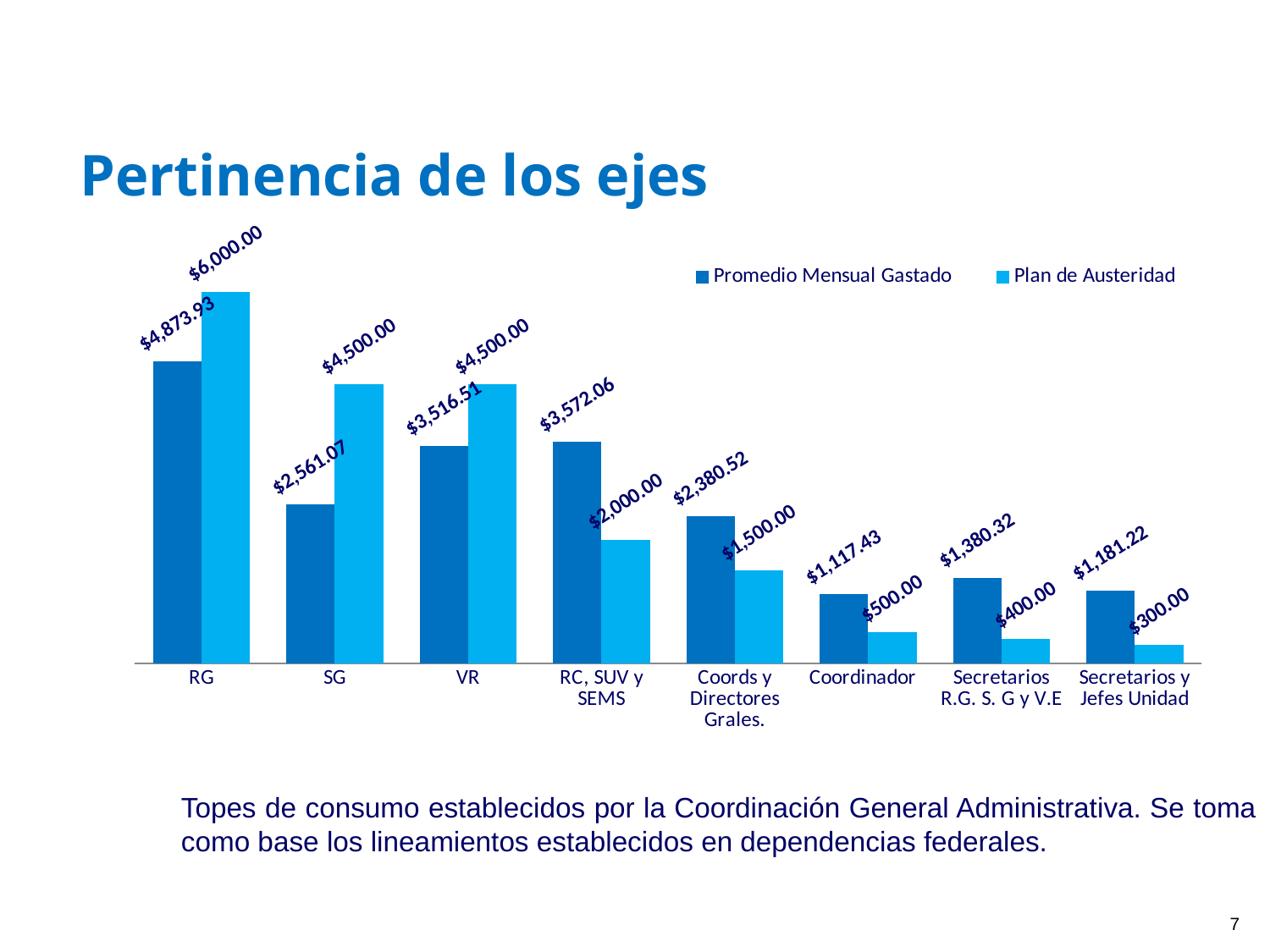
What kind of chart is shown on the slide? Bar chart Which category has the highest Plan de Austeridad value? RG Which series is shown in the lighter blue colour? Plan de Austeridad What is the Plan de Austeridad value for SG? $4,500.00 For RC, SUV y SEMS, which is larger: Promedio Mensual Gastado or Plan de Austeridad? Promedio Mensual Gastado What is the Promedio Mensual Gastado value for Coordinador? $1,117.43 What is the Promedio Mensual Gastado value for RG? $4,873.93 How many categories are shown on the x axis? 8 What is the Plan de Austeridad value for Secretarios y Jefes Unidad? $300.00 What is the difference between the Plan de Austeridad and Promedio Mensual Gastado values for RG? $1,126.07 How many series does the legend list? 2 Which category has the lowest Promedio Mensual Gastado value? Coordinador